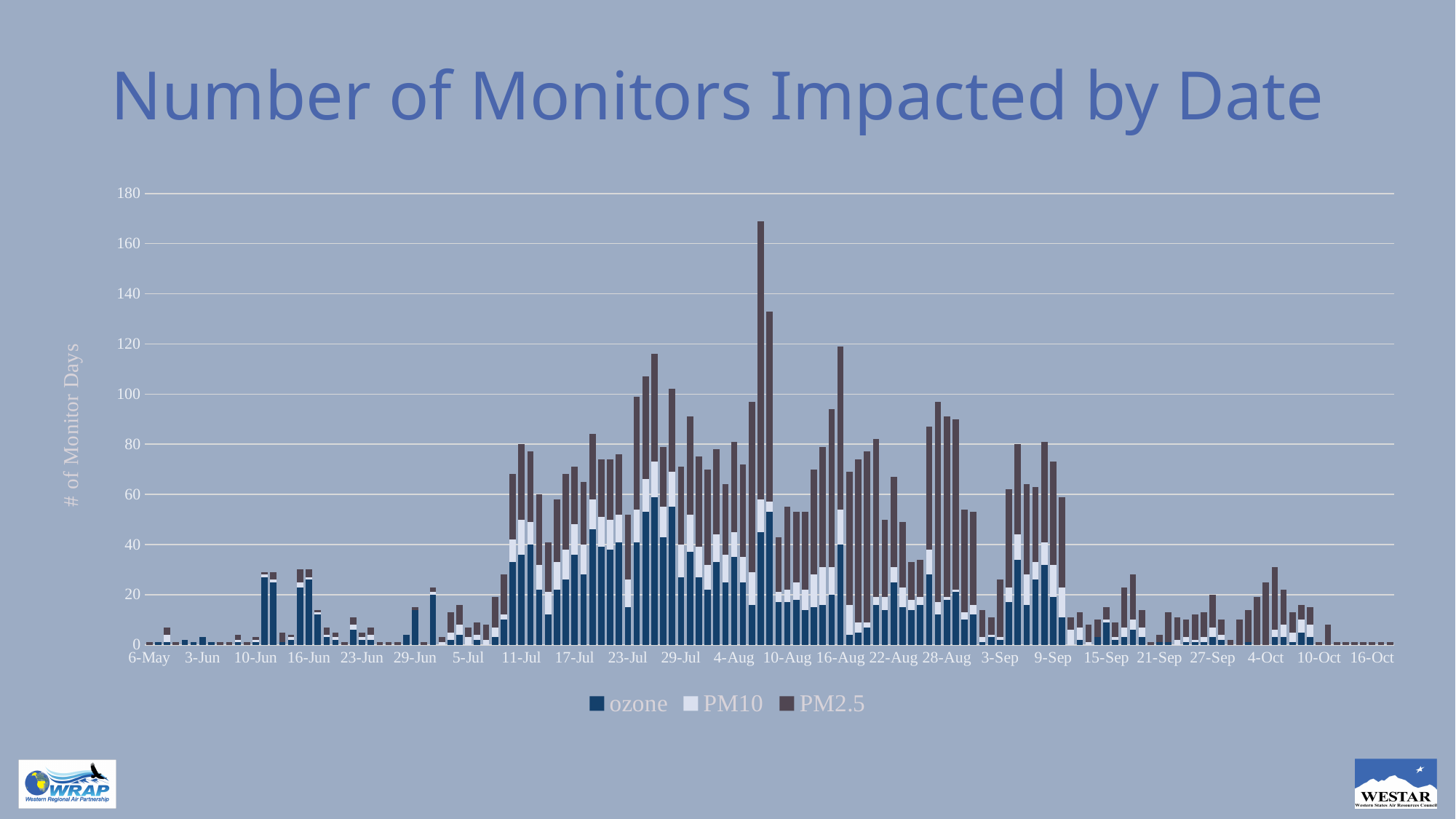
Around which month does the number of monitors impacted reach its peak? August Is the total for the bar at 6-May greater or less than 20? less What are the three series listed in the legend? ozone, PM10, PM2.5 What is the label on the vertical axis? # of Monitor Days What kind of chart is shown on the slide? Stacked bar chart Is the tallest stacked bar greater or less than 180? less Is the total for the bar at 16-Oct greater or less than 20? less How do the values change from early July through mid-August and then into October? They rise to a peak in August, then fall Which series is plotted at the bottom of each stacked bar? ozone How many series does the legend list? 3 In the tallest bar, which series contributes the largest segment: ozone or PM2.5? PM2.5